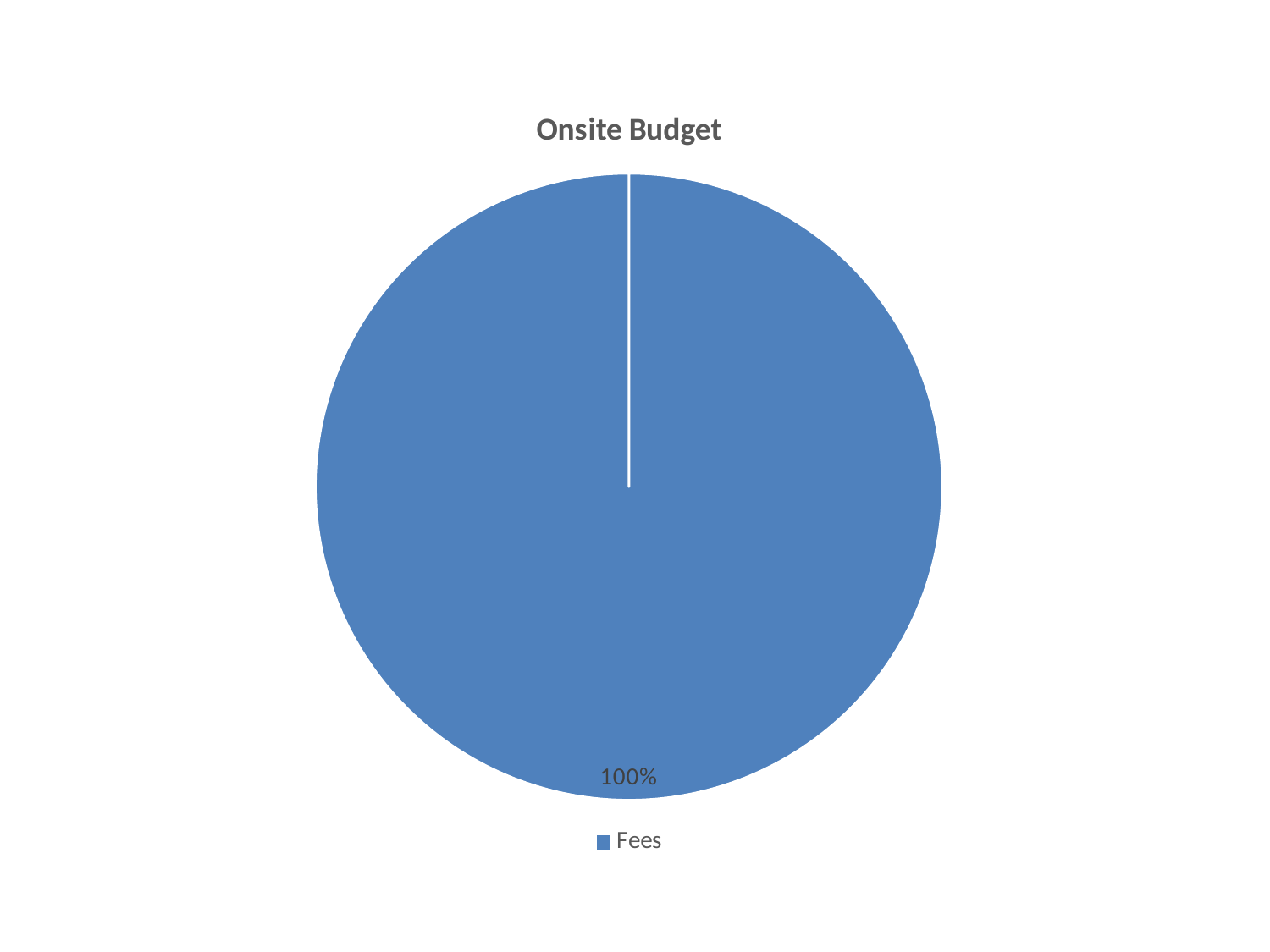
Which category has the largest share of the pie? Fees What share of the pie does the Fees slice represent? 100% What kind of chart is shown on the slide? pie chart How many slices does the pie chart have? 1 What is the label of the only category in the legend? Fees What is the data label printed on the Fees slice? 100% What is the title of the chart? Onsite Budget How many entries does the legend list? 1